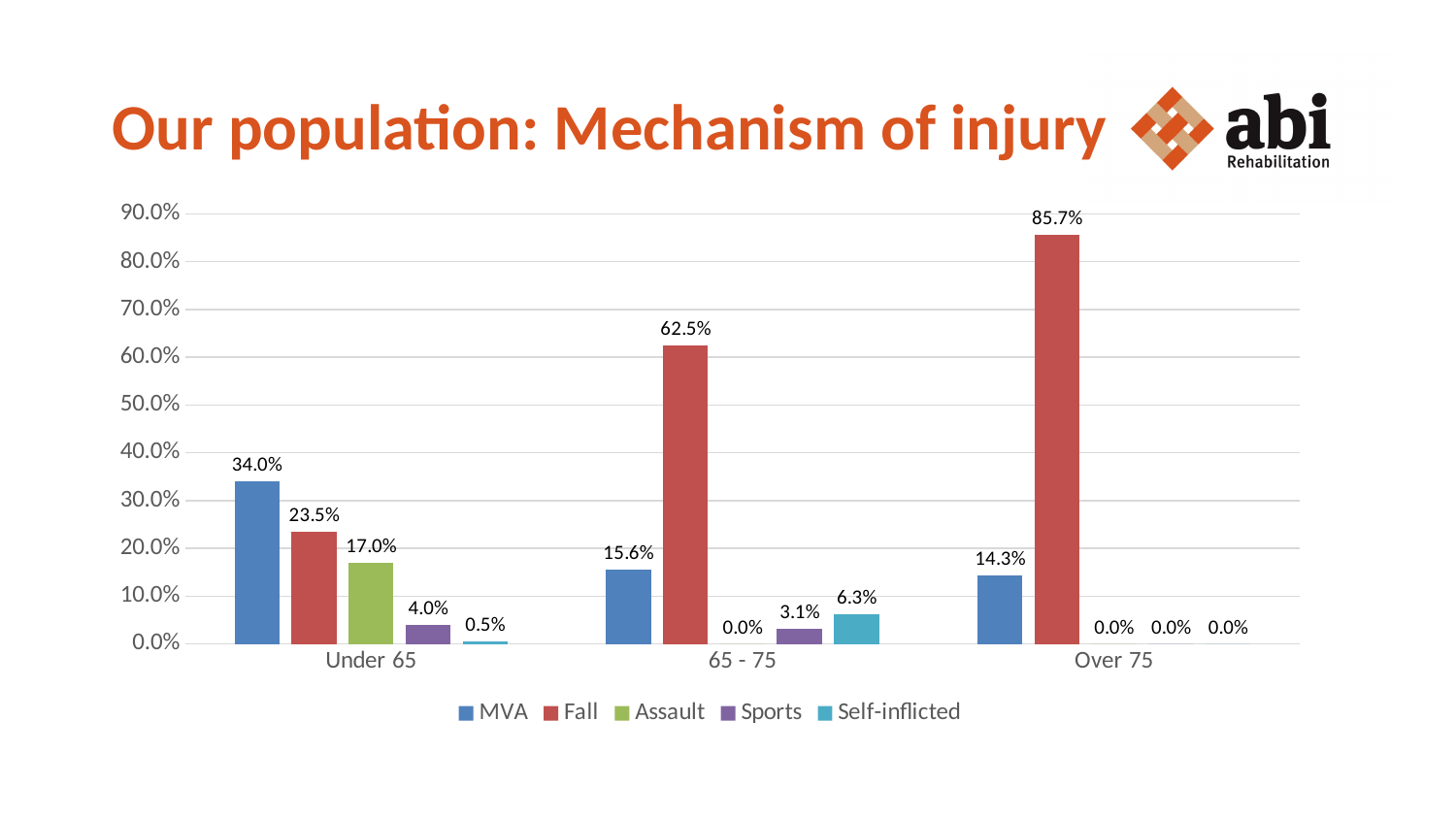
Does the value for Fall rise or fall across the age groups from Under 65 to Over 75? Rise What is the value for Fall in the Over 75 group? 85.7% What kind of chart is shown on the slide? Bar chart What is the value for Self-inflicted in the 65 - 75 group? 6.3% Which mechanism of injury has the lowest value in the Under 65 group? Self-inflicted What is the difference between the Fall values for Over 75 and 65 - 75? 23.2% What is the value for Assault in the Under 65 group? 17.0% How many age groups are shown on the x axis? 3 What is the value for MVA in the Under 65 group? 34.0% Which is larger in the Under 65 group, MVA or Fall? MVA How many series does the legend list? 5 Which age group has the highest value for Fall? Over 75